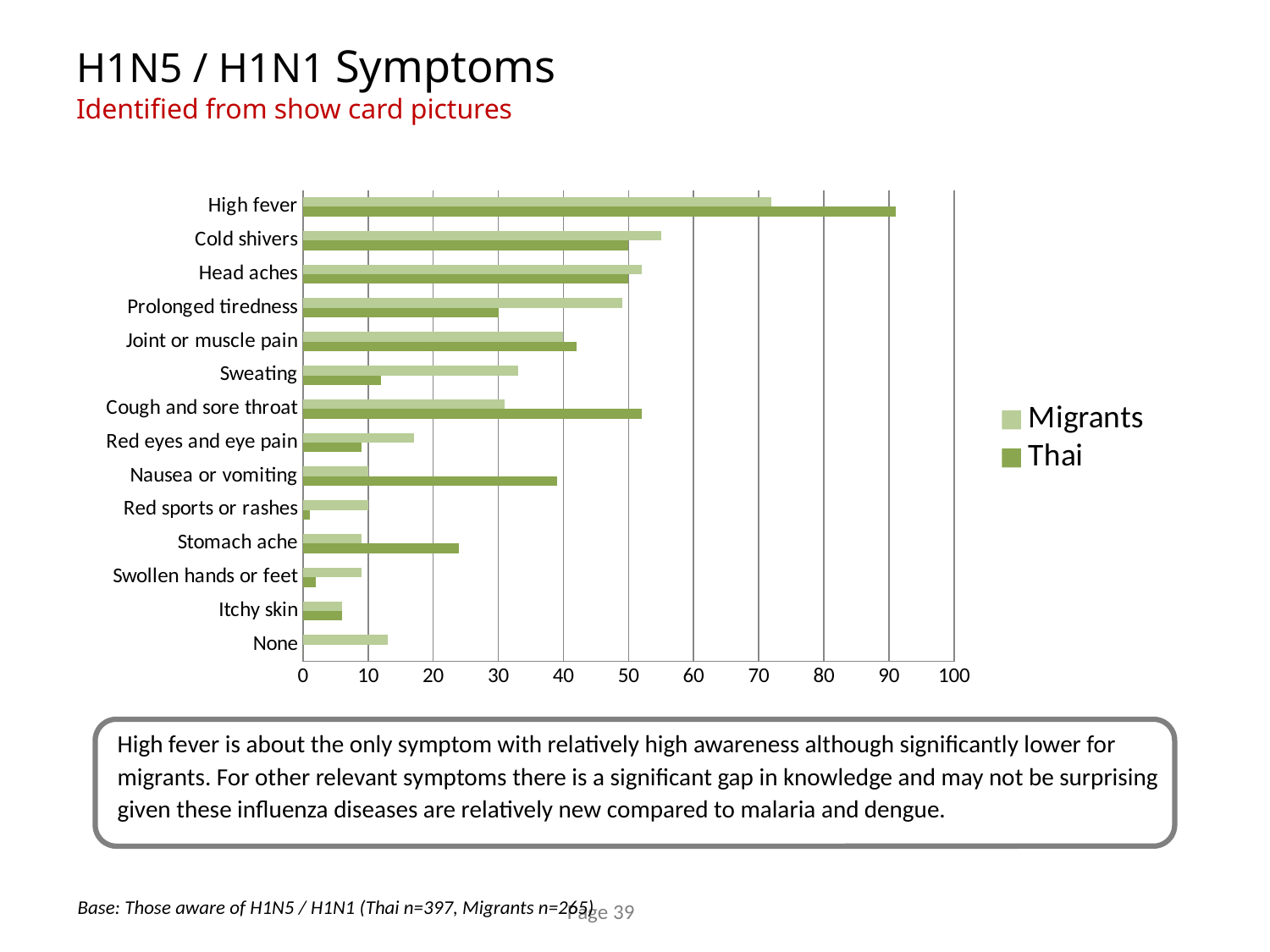
Which symptom has the highest value for Migrants? High fever Is the Migrants value for High fever greater or less than 70? greater Is the Thai value for Prolonged tiredness greater or less than 40? less Which symptom has the highest value for Thai? High fever For Cough and sore throat, which series has the larger value, Migrants or Thai? Thai What are the two entries in the chart legend? Migrants and Thai What kind of chart is shown on the slide? bar chart How many symptom categories are plotted on the chart? 14 How many series does the legend list? 2 For Nausea or vomiting, which series has the larger value, Migrants or Thai? Thai For Sweating, which series has the larger value, Migrants or Thai? Migrants